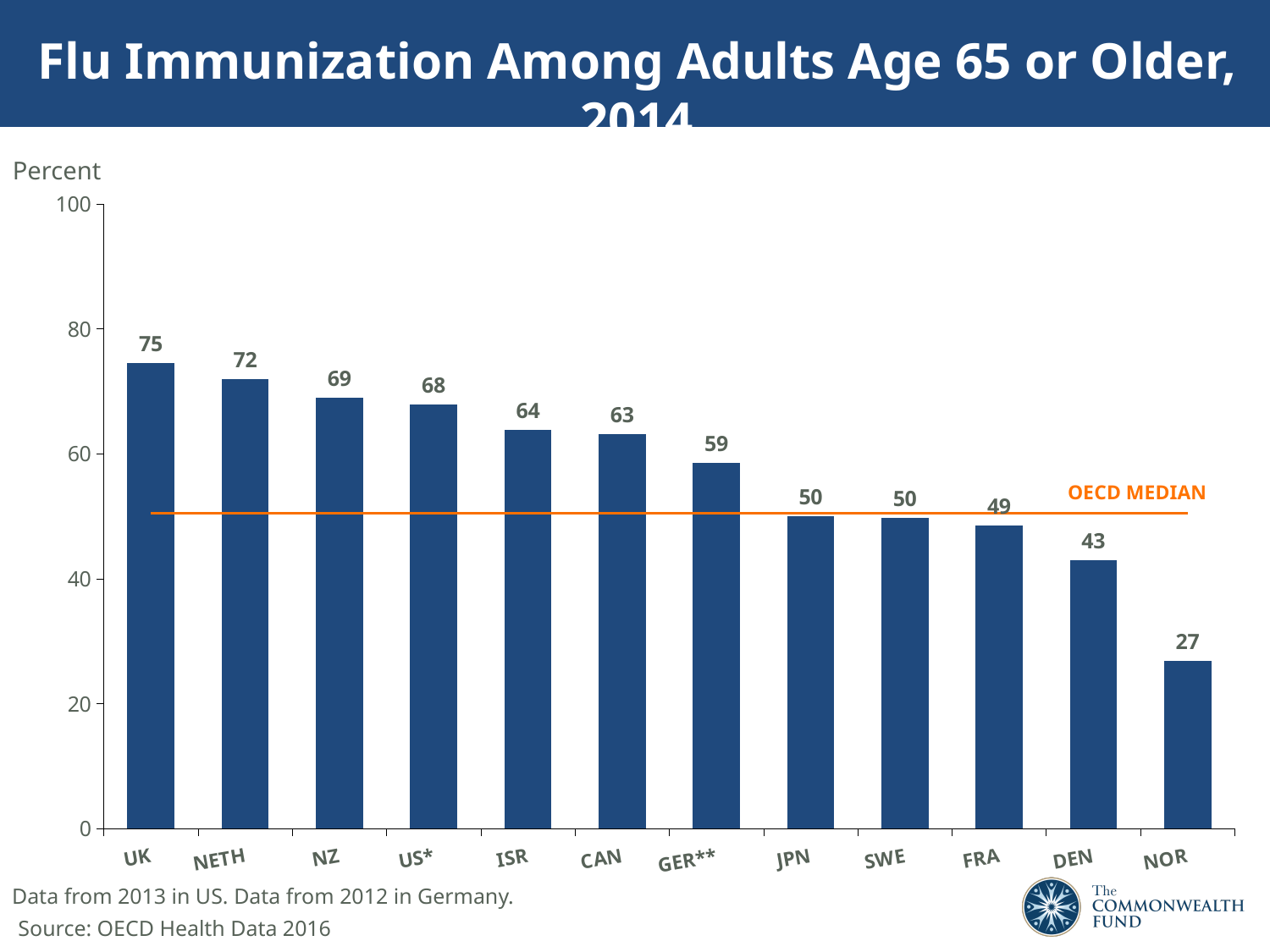
Which has a higher value, ISR or CAN? ISR What is the flu immunization rate for the UK? 75 What does the orange horizontal line on the chart represent? OECD MEDIAN How many countries are shown on the chart? 12 What is the value shown for DEN? 43 Do the values rise or fall from left to right along the x axis? fall What kind of chart is shown on the slide? bar chart Is the value for FRA greater or less than 60? less What is the difference between the values for NETH and NOR? 45 Which country has the lowest flu immunization rate? NOR Which country has the highest flu immunization rate? UK What is the value shown for GER**? 59